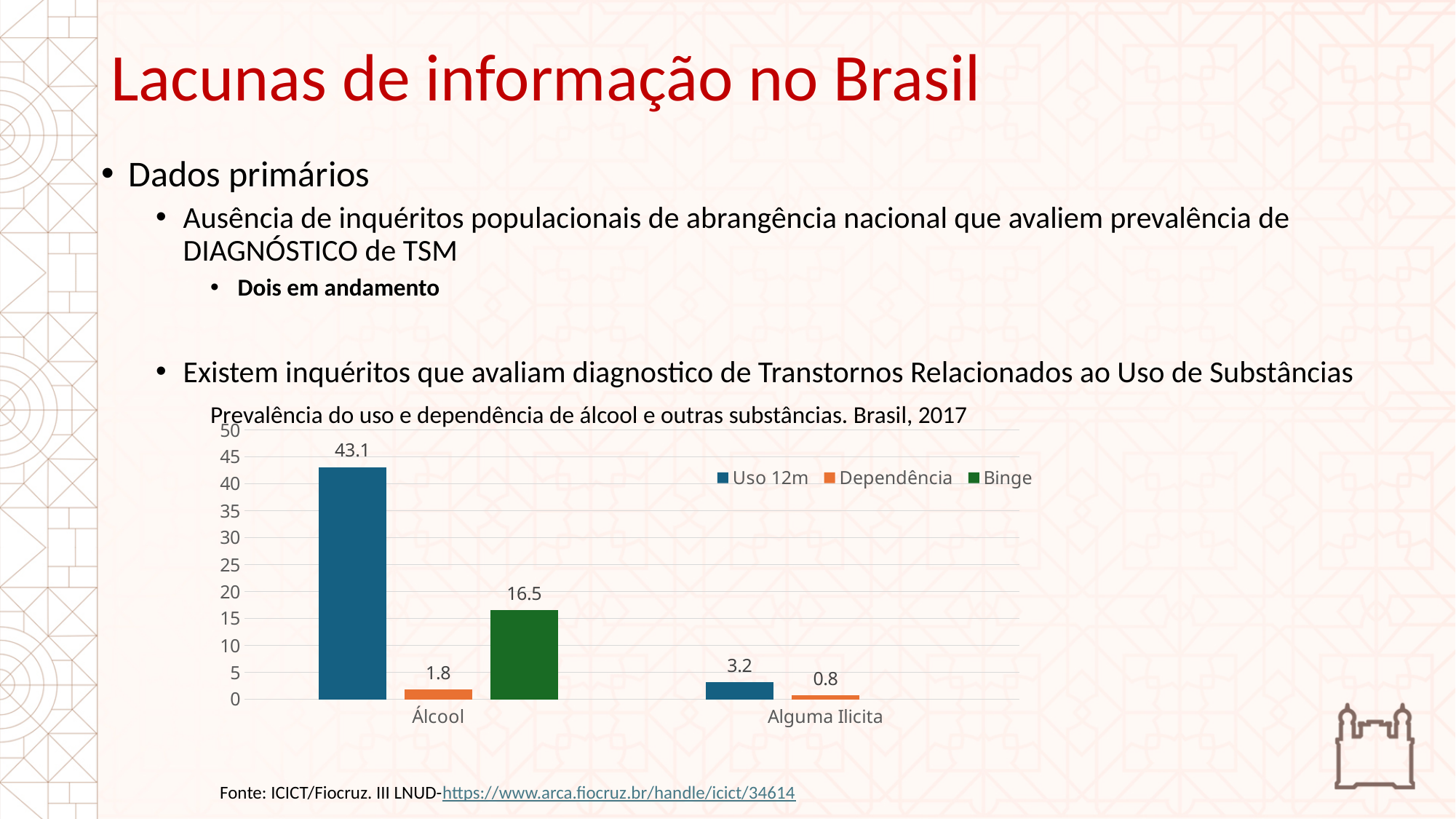
Which series has the lowest value for Alguma Ilicita? Dependência What is the title of the chart? Prevalência do uso e dependência de álcool e outras substâncias. Brasil, 2017 What kind of chart is shown on the slide? Bar chart Which category has the highest Uso 12m value? Álcool What is the difference between Uso 12m and Binge for Álcool? 26.6 What is the value of Uso 12m for Álcool? 43.1 What is the value of Dependência for Alguma Ilicita? 0.8 How many series does the legend list? 3 Which is larger: Dependência for Álcool or Dependência for Alguma Ilicita? Dependência for Álcool How many categories are shown on the x axis? 2 What is the value of Binge for Álcool? 16.5 What is the value of Uso 12m for Alguma Ilicita? 3.2